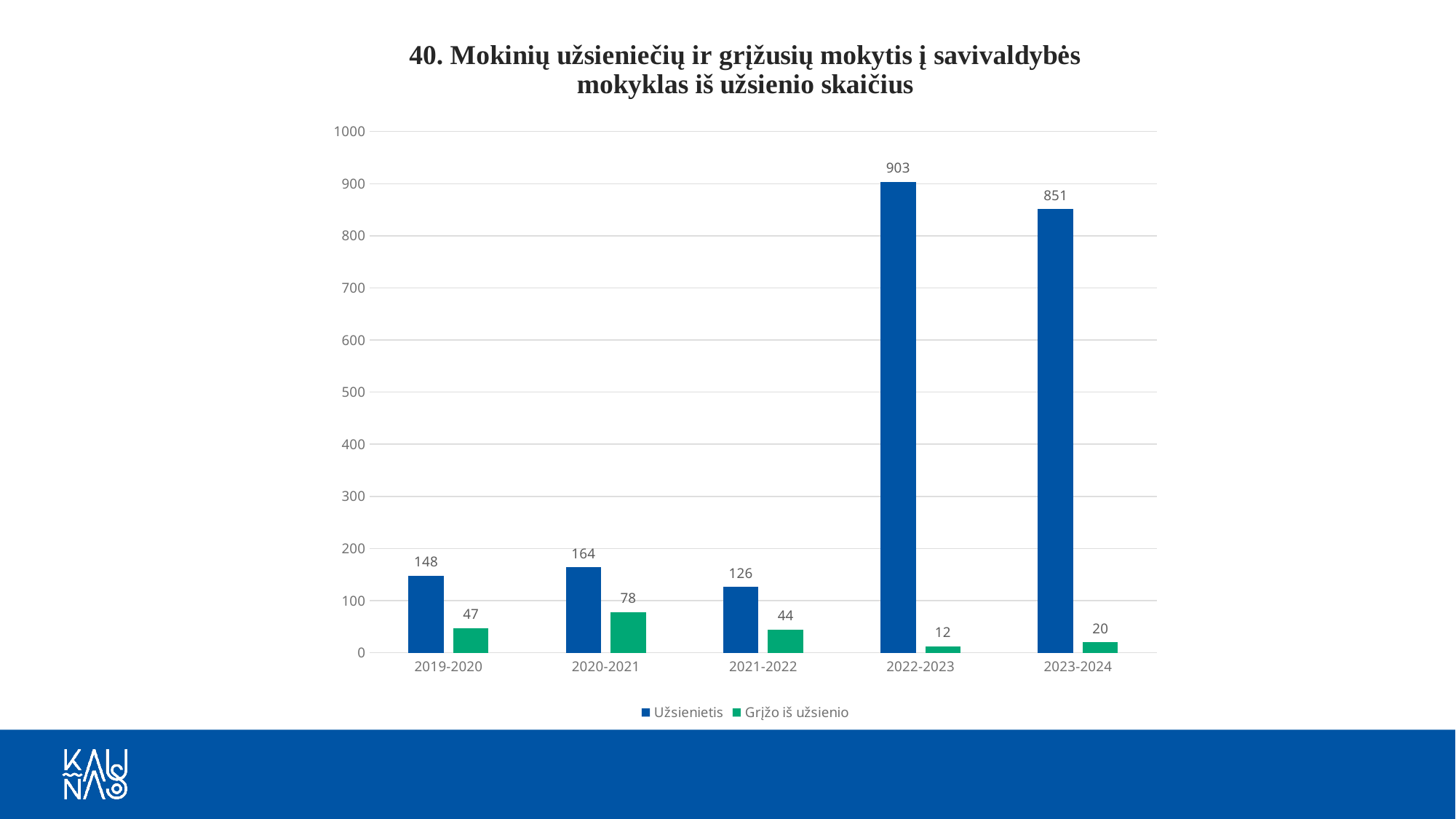
What is the difference between the Užsienietis values for 2022-2023 and 2023-2024? 52 What is the value for Užsienietis in 2022-2023? 903 How many school years are shown on the x axis? 5 What kind of chart is shown on the slide? Bar chart Is the value for Užsienietis in 2023-2024 greater or less than 800? greater What is the value for Grįžo iš užsienio in 2020-2021? 78 Which is larger: Grįžo iš užsienio in 2019-2020 or in 2021-2022? 2019-2020 Which school year has the highest value for Užsienietis? 2022-2023 What is the value for Užsienietis in 2021-2022? 126 What is the difference between the Užsienietis and Grįžo iš užsienio values in 2019-2020? 101 Which school year has the lowest value for Grįžo iš užsienio? 2022-2023 How many series does the legend list? 2